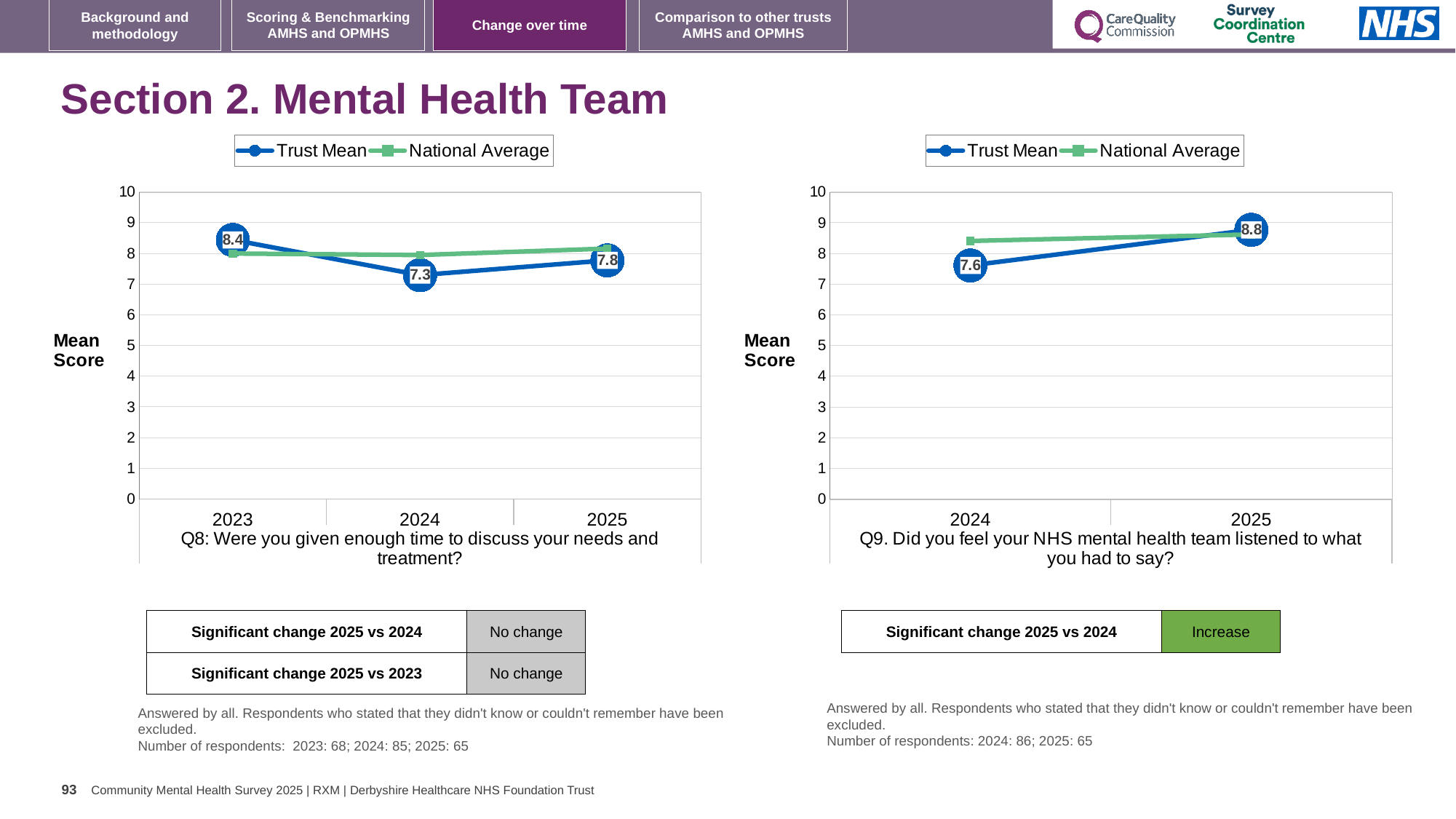
What type of chart is used for Q8 (left)? Line chart On the Q9 chart (right), is the National Average for 2024 greater or less than 8? greater On the Q9 chart (right), what is the difference between the Trust Mean for 2025 and 2024? 1.2 On the Q8 chart (left), which year has the lowest Trust Mean? 2024 On the Q9 chart (right), what is the Trust Mean for 2025? 8.8 On the Q8 chart (left), what is the Trust Mean for 2023? 8.4 How many series does the legend of the Q8 chart (left) list? 2 On the Q8 chart (left), which year has the highest Trust Mean? 2023 On the Q9 chart (right), does the Trust Mean rise or fall from 2024 to 2025? Rise On the Q8 chart (left), what is the Trust Mean for 2024? 7.3 How many years are plotted on the Q9 chart (right)? 2 On the Q8 chart (left), is the Trust Mean higher in 2023 or 2025? 2023